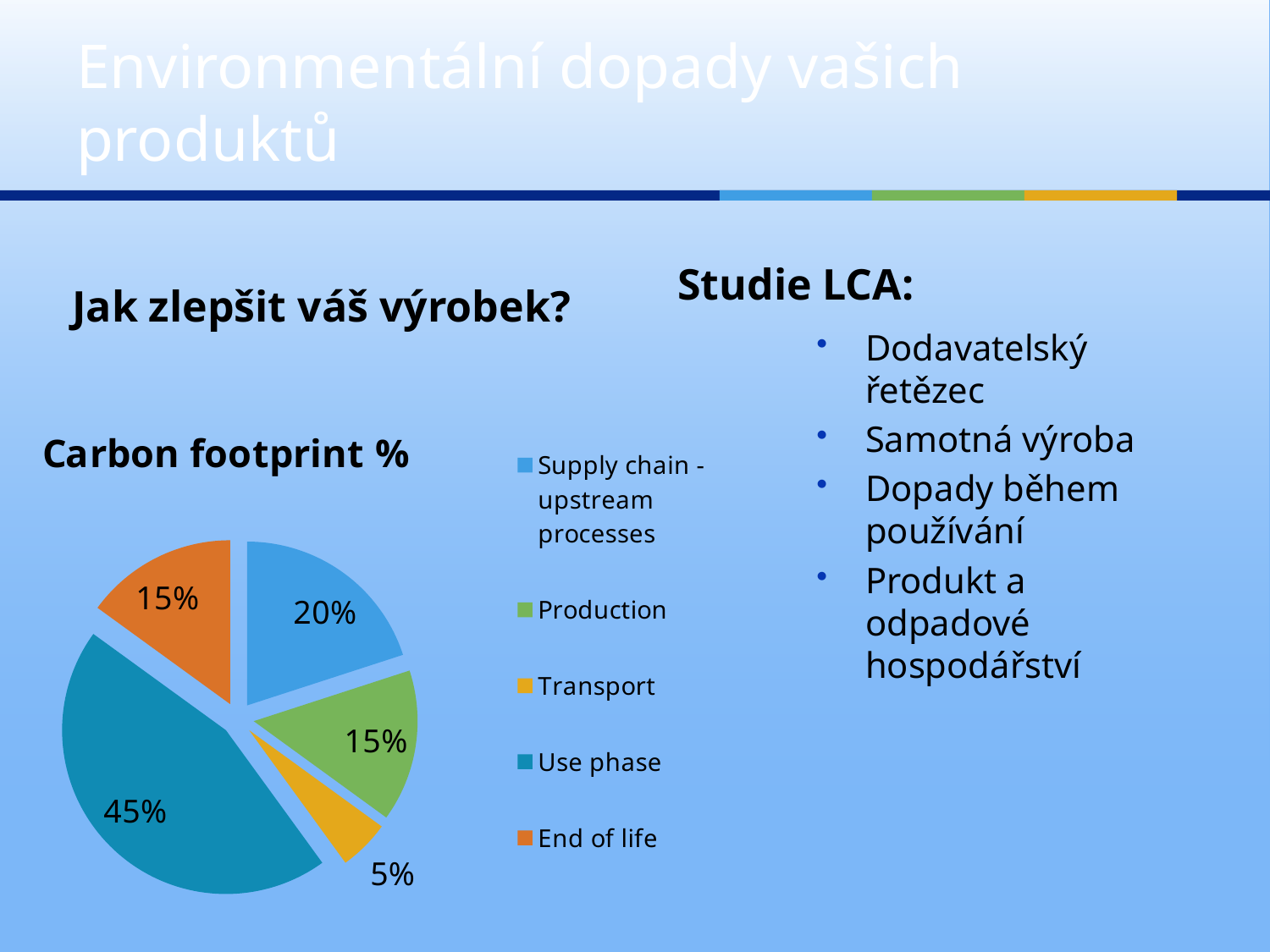
What share of the carbon footprint does Production represent? 15% How many entries does the legend list? 5 What share of the carbon footprint does Supply chain - upstream processes represent? 20% Which category has the largest share of the carbon footprint? Use phase What share of the carbon footprint does the Use phase slice represent? 45% Which is larger, the share for End of life or the share for Transport? End of life Which category has the smallest share of the carbon footprint? Transport What share of the carbon footprint does Transport represent? 5% What type of chart is shown on the slide? pie chart What is the title of the chart? Carbon footprint % What is the difference in percentage points between the Use phase and Supply chain - upstream processes shares? 25 How many slices does the pie chart have? 5